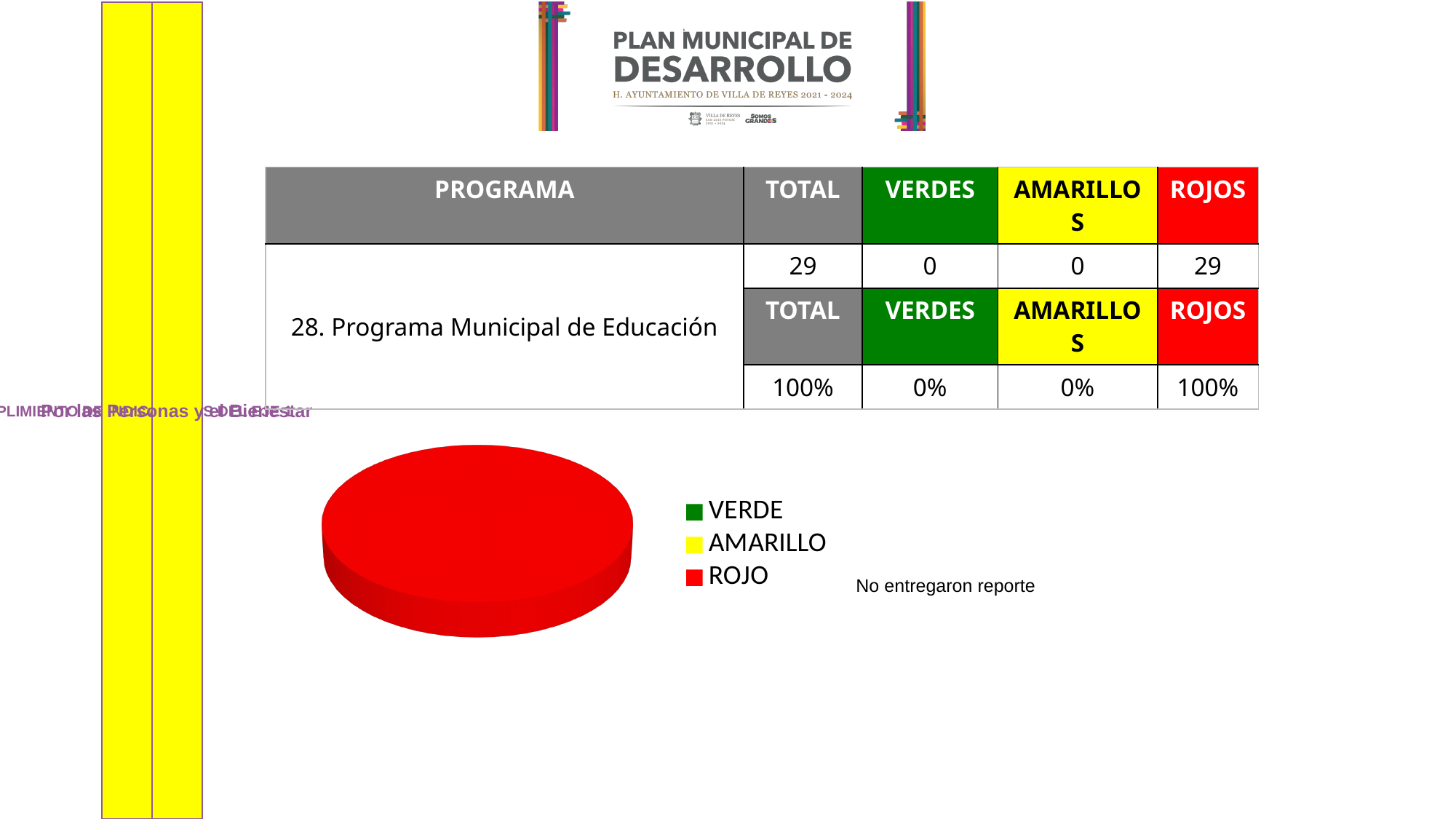
What colour is the ROJO category in the pie chart legend? red What share of the pie does the ROJO category represent? 100% What share of the pie does the VERDE category represent? 0% How many entries does the legend of the pie chart list? 3 Which is larger in the pie chart, the ROJO slice or the VERDE slice? ROJO Which is larger in the pie chart, the ROJO slice or the AMARILLO slice? ROJO Which category occupies the largest share of the pie chart? ROJO What kind of chart is shown on the slide? pie chart What share of the pie does the AMARILLO category represent? 0% What colour is the VERDE category in the pie chart legend? green